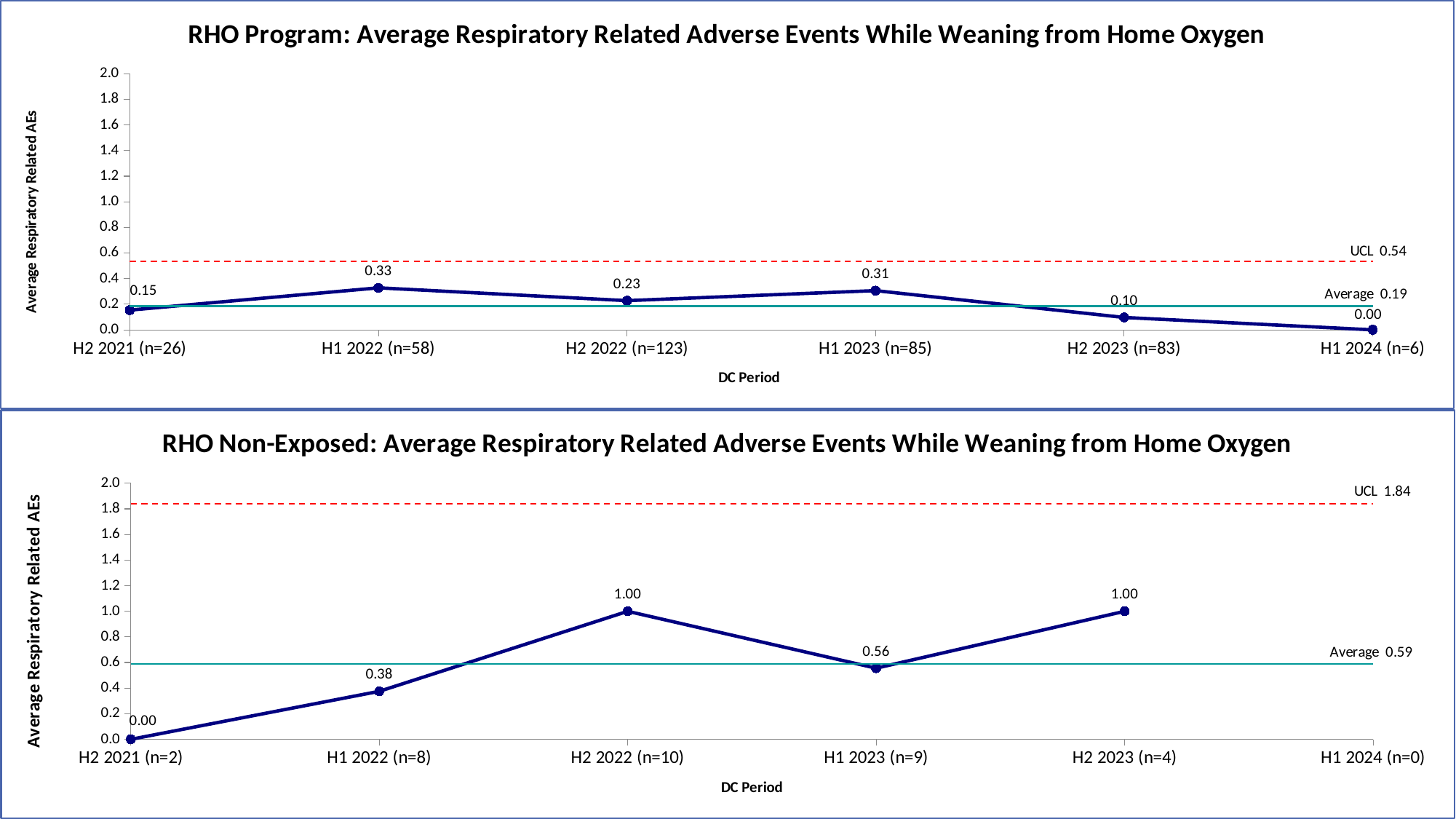
In the RHO Non-Exposed chart, is the value for H2 2022 (n=10) larger or smaller than the value for H1 2023 (n=9)? larger In the RHO Non-Exposed chart, which DC period has the lowest average respiratory related AEs? H2 2021 (n=2) In the RHO Program chart, what is the UCL value shown? 0.54 In the RHO Non-Exposed chart, what is the Average line value shown? 0.59 In the RHO Non-Exposed chart, what is the value for H1 2022 (n=8)? 0.38 In the RHO Program chart, what is the value for H2 2023 (n=83)? 0.10 What type of chart is the RHO Program chart? line chart In the RHO Program chart, what is the difference between the values for H1 2022 (n=58) and H2 2022 (n=123)? 0.10 In the RHO Program chart, which DC period has the highest average respiratory related AEs? H1 2022 (n=58) In the RHO Program chart, what is the average respiratory related AEs value for H1 2022 (n=58)? 0.33 In the RHO Non-Exposed chart, what is the value for H1 2023 (n=9)? 0.56 In the RHO Program chart, which DC period has the lowest average respiratory related AEs? H1 2024 (n=6)